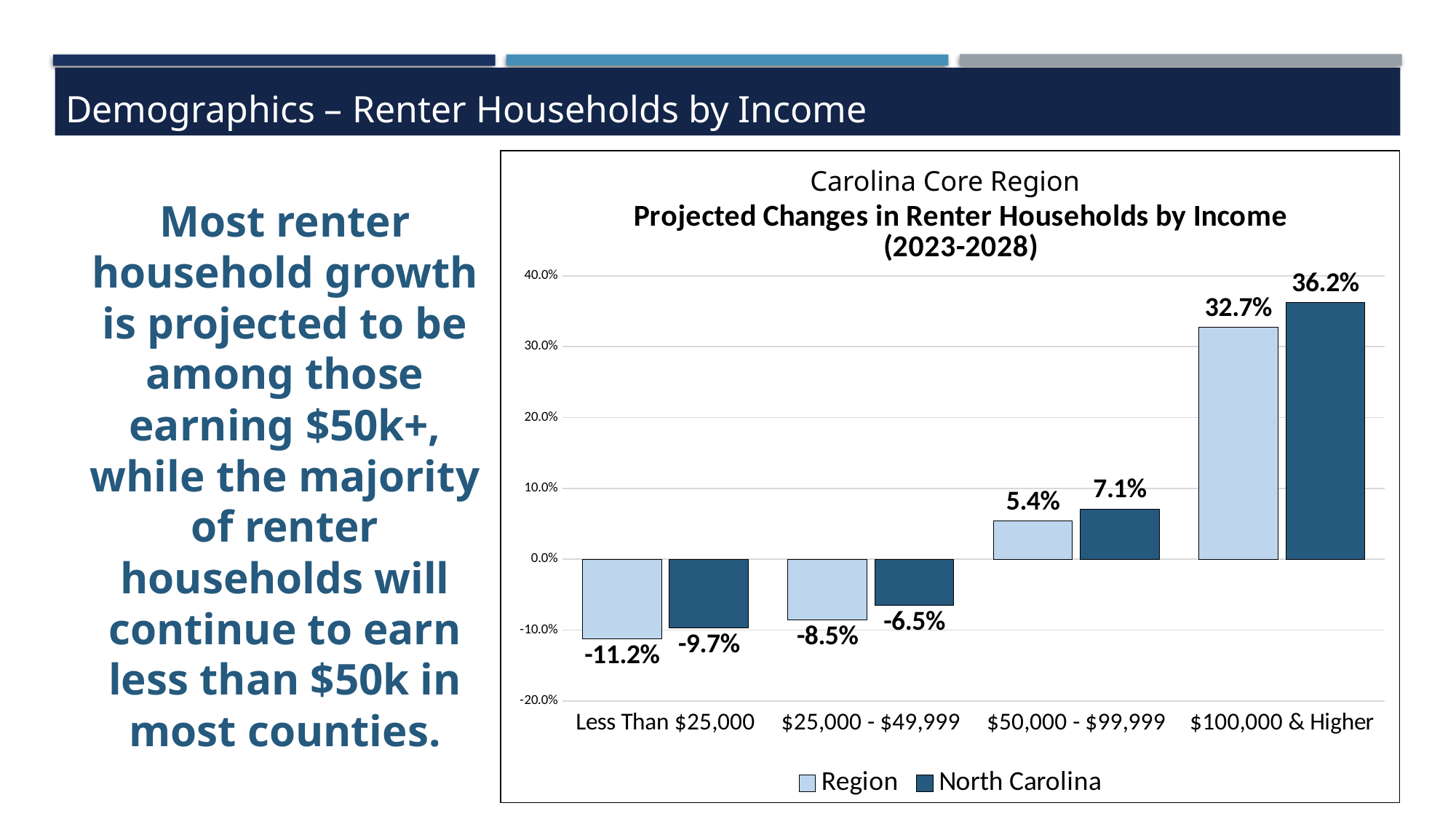
What kind of chart is shown on the slide? Bar chart What is the difference between the North Carolina and Region values in the $100,000 & Higher category? 3.5% What is the projected change for the Region in the $25,000 - $49,999 income category? -8.5% Which income category has the lowest projected change for the Region? Less Than $25,000 In the $50,000 - $99,999 category, which series has the larger value, Region or North Carolina? North Carolina How many series does the legend list? 2 Do the Region values rise or fall as income categories move from left to right along the x axis? Rise What is the projected change for North Carolina in the $50,000 - $99,999 income category? 7.1% What is the projected change for the Region in the $100,000 & Higher income category? 32.7% What is the projected change for North Carolina in the Less Than $25,000 income category? -9.7% How many income categories are shown on the x axis? 4 Which income category has the highest projected change for North Carolina? $100,000 & Higher